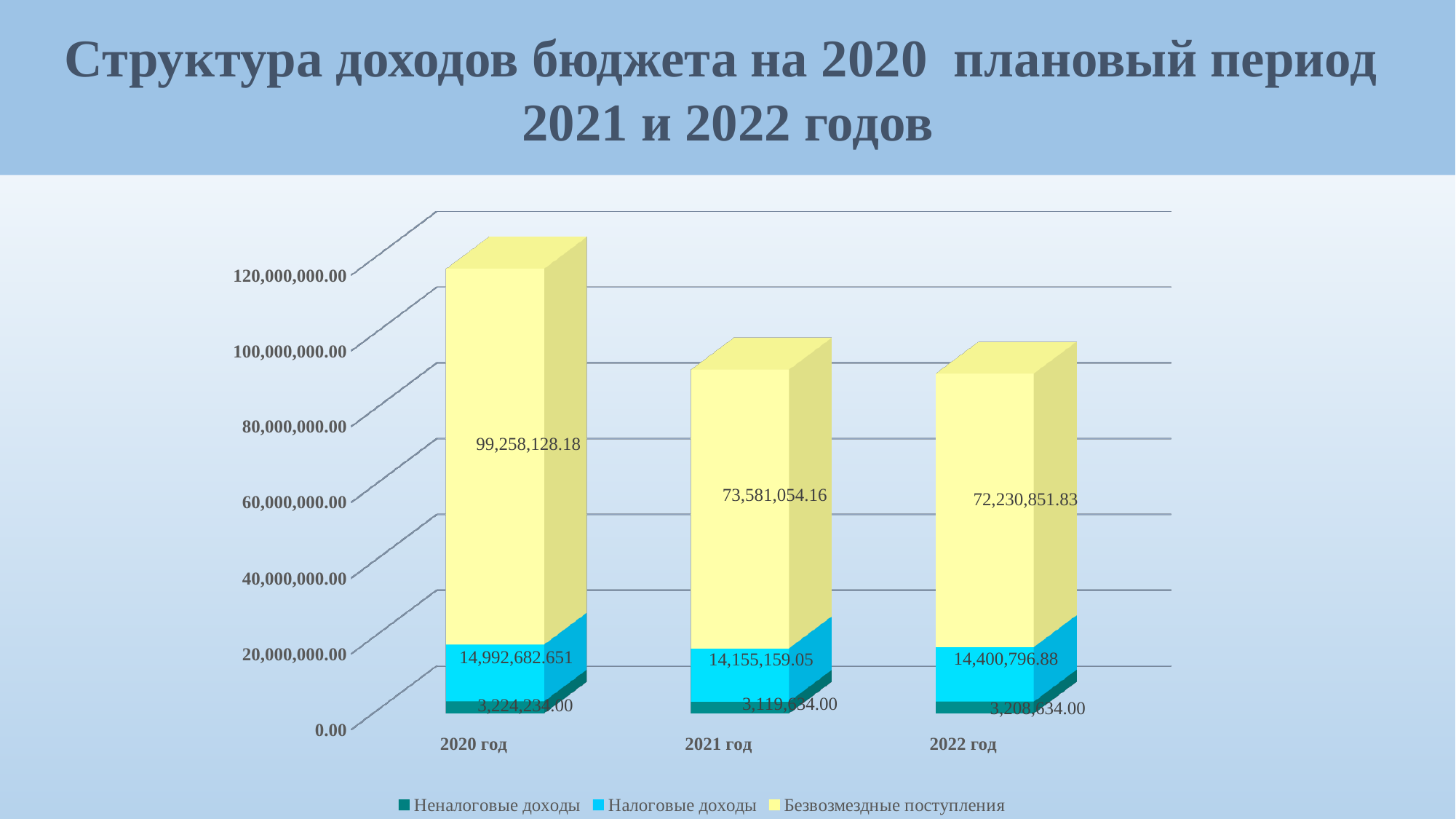
What is the value of Налоговые доходы for 2021 год? 14,155,159.05 What is the value of Неналоговые доходы for 2020 год? 3,224,234.00 What is the value of Безвозмездные поступления for 2020 год? 99,258,128.18 What is the difference in Безвозмездные поступления between 2020 год and 2021 год? 25,677,074.02 Does Безвозмездные поступления rise or fall from 2020 год to 2022 год? fall Which is larger: Налоговые доходы in 2020 год or in 2021 год? 2020 год Is the total height of the 2021 год bar greater or less than 100,000,000.00? less What is the value of Безвозмездные поступления for 2022 год? 72,230,851.83 In which year is Безвозмездные поступления highest? 2020 год How many series does the legend list? 3 In which year is Безвозмездные поступления lowest? 2022 год How many years are shown on the x axis? 3